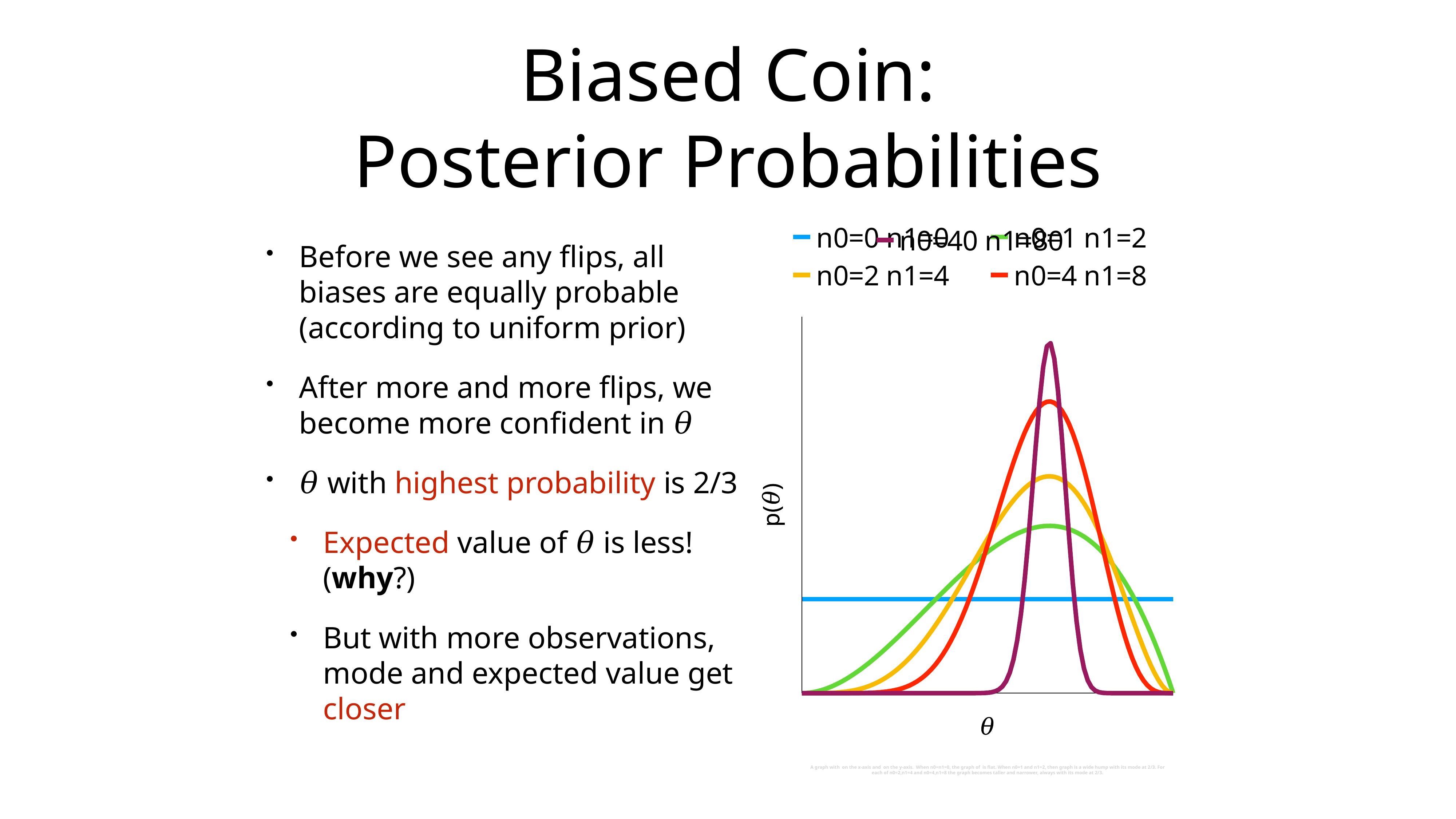
What colour is the n0=0 n1=0 line in the chart? blue Among the humped curves in the chart, which colour line has the lowest peak? green Which has the higher peak in the chart, the red line or the green line? red Which has the higher peak in the chart, the n0=4 n1=8 line or the n0=2 n1=4 line? n0=4 n1=8 What is the label on the y axis of the chart? p(θ) What kind of chart is shown on the slide? line chart Which colour line in the chart is the narrowest curve? purple Which series in the chart is drawn as a flat horizontal line? n0=0 n1=0 Which colour line in the chart reaches the highest peak? purple How many series does the chart's legend list? 5